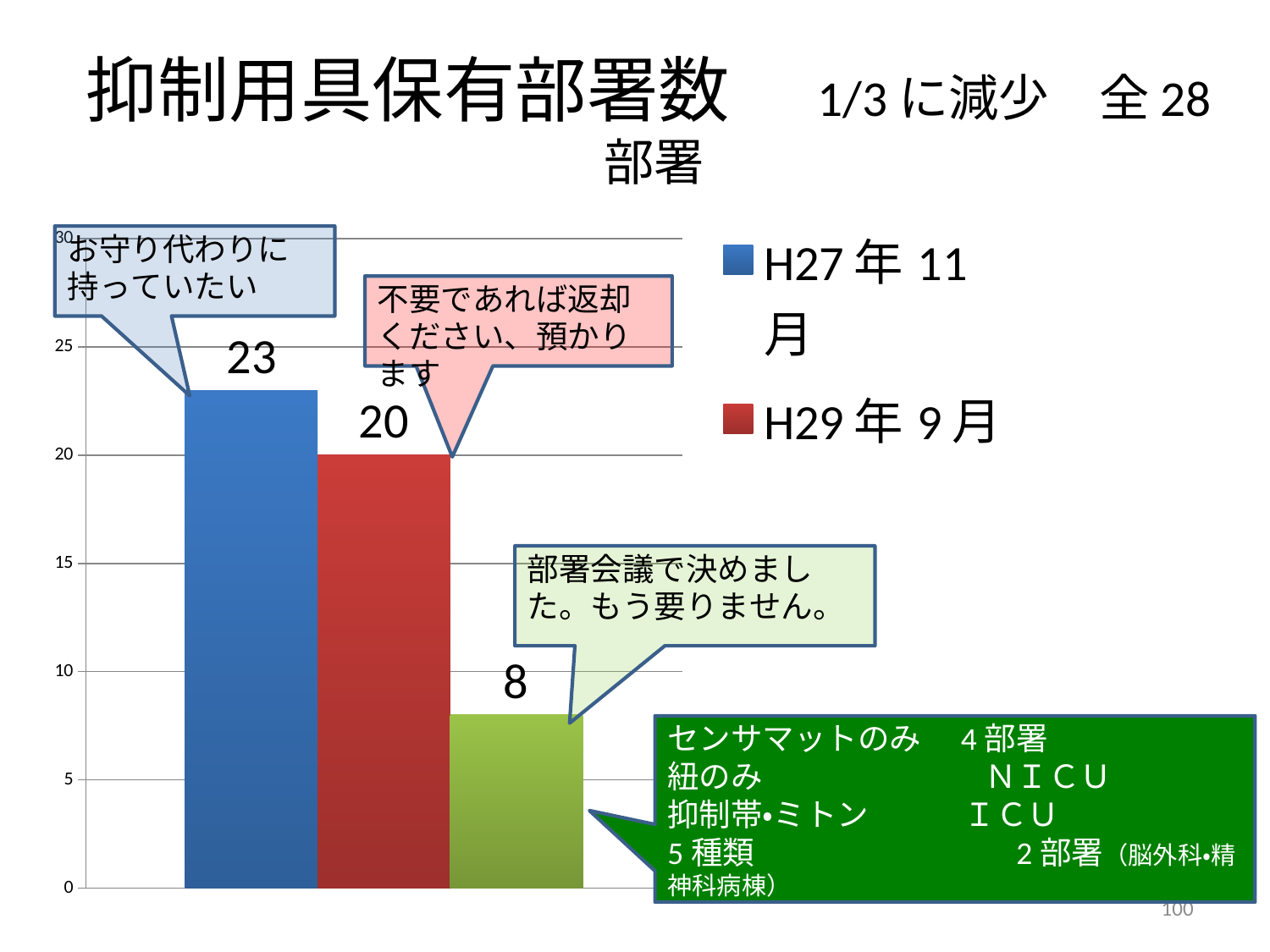
What is the value shown on the green (third) bar? 8 Do the bar values rise or fall from left to right? fall What is the value of the H29年9月 bar? 20 What is the difference between the H27年11月 bar and the green (third) bar? 15 What kind of chart is shown on the slide? bar chart What is the difference between the H27年11月 bar and the H29年9月 bar? 3 Which bar has the lowest value? the green (third) bar Which is larger, the H29年9月 bar or the green (third) bar? H29年9月 How many bars are plotted in the chart? 3 What is the value of the H27年11月 bar? 23 Which bar has the highest value? H27年11月 How many series does the legend list? 2